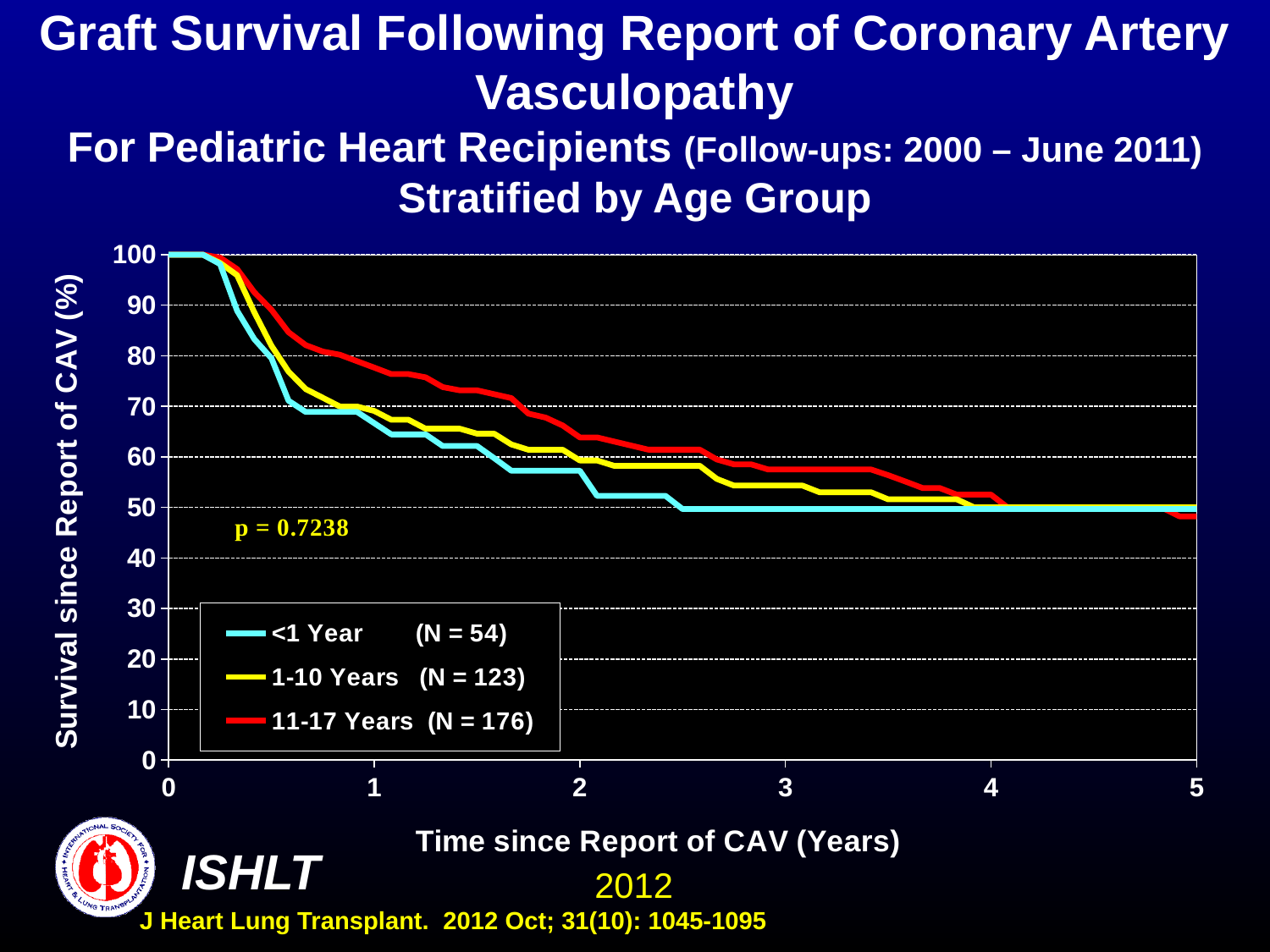
At 2 years since report of CAV, is survival for the 11-17 Years group greater or less than 60%? greater How many series does the legend list? 3 Do the survival curves rise or fall as time since report of CAV increases? Fall At 1 year since report of CAV, is survival for the 11-17 Years group greater or less than 70%? greater What kind of chart is shown on the slide? Line chart What is the maximum value shown on the x axis (Time since Report of CAV, Years)? 5 At 1 year since report of CAV, which group has higher survival: <1 Year or 11-17 Years? 11-17 Years At 0.5 years since report of CAV, which group has lower survival: <1 Year or 11-17 Years? <1 Year At 2 years since report of CAV, is survival for the <1 Year group greater or less than 60%? less Which age group has the largest number of patients (N) according to the legend? 11-17 Years (N = 176) Which age group has the lowest survival at 2 years since report of CAV? <1 Year What p-value is printed on the chart? p = 0.7238